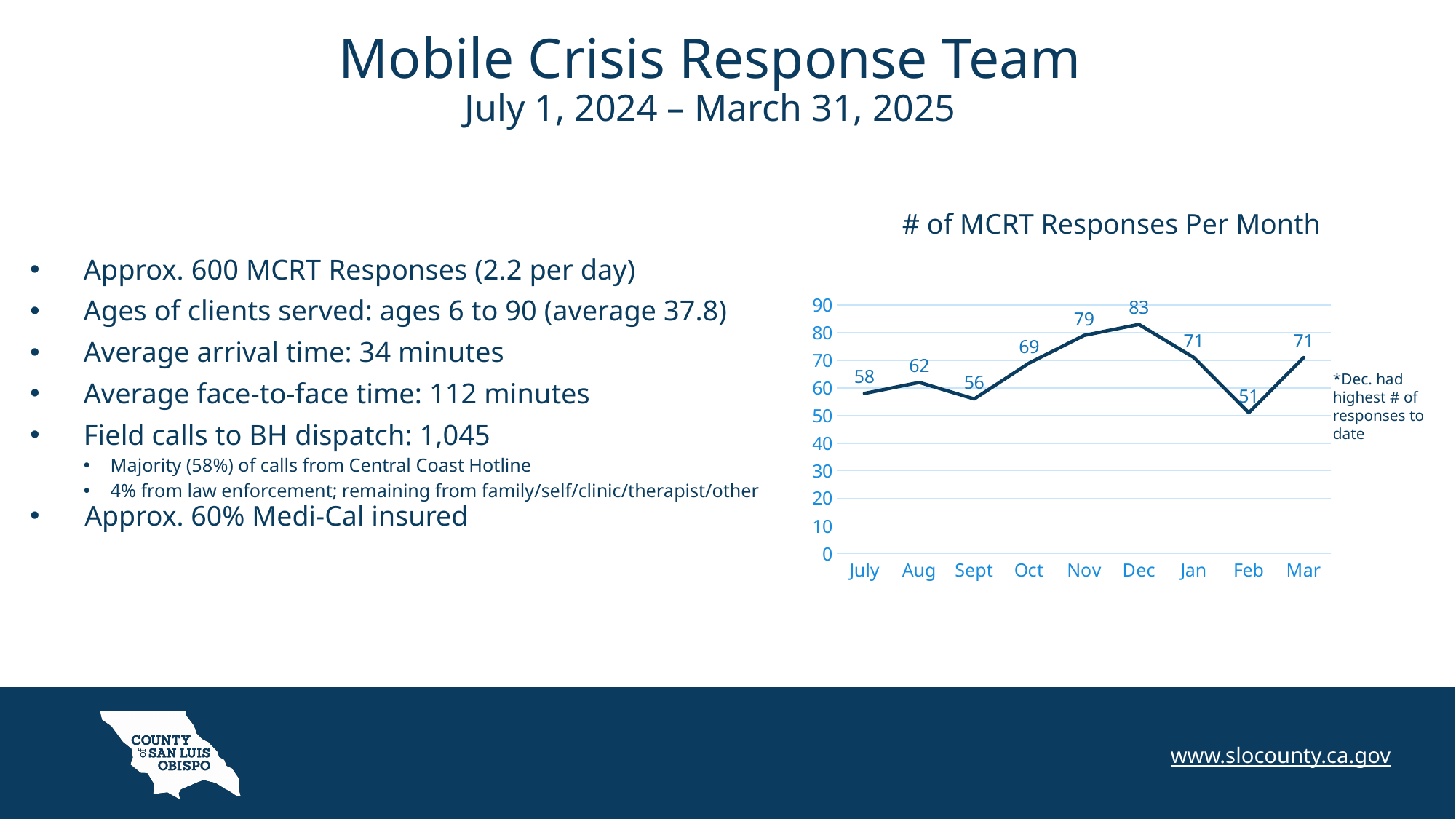
What is the title of the chart? # of MCRT Responses Per Month What is the number of MCRT responses in December? 83 Is the value for September greater or less than 60? less What type of chart is shown on the slide? line chart Which month has the highest number of MCRT responses? Dec What is the number of MCRT responses in February? 51 Which month has the lowest number of MCRT responses? Feb Which month has more MCRT responses, November or October? Nov How many months are plotted on the chart? 9 Do the MCRT responses rise or fall from September to December? rise What is the number of MCRT responses in July? 58 What is the difference in MCRT responses between December and February? 32